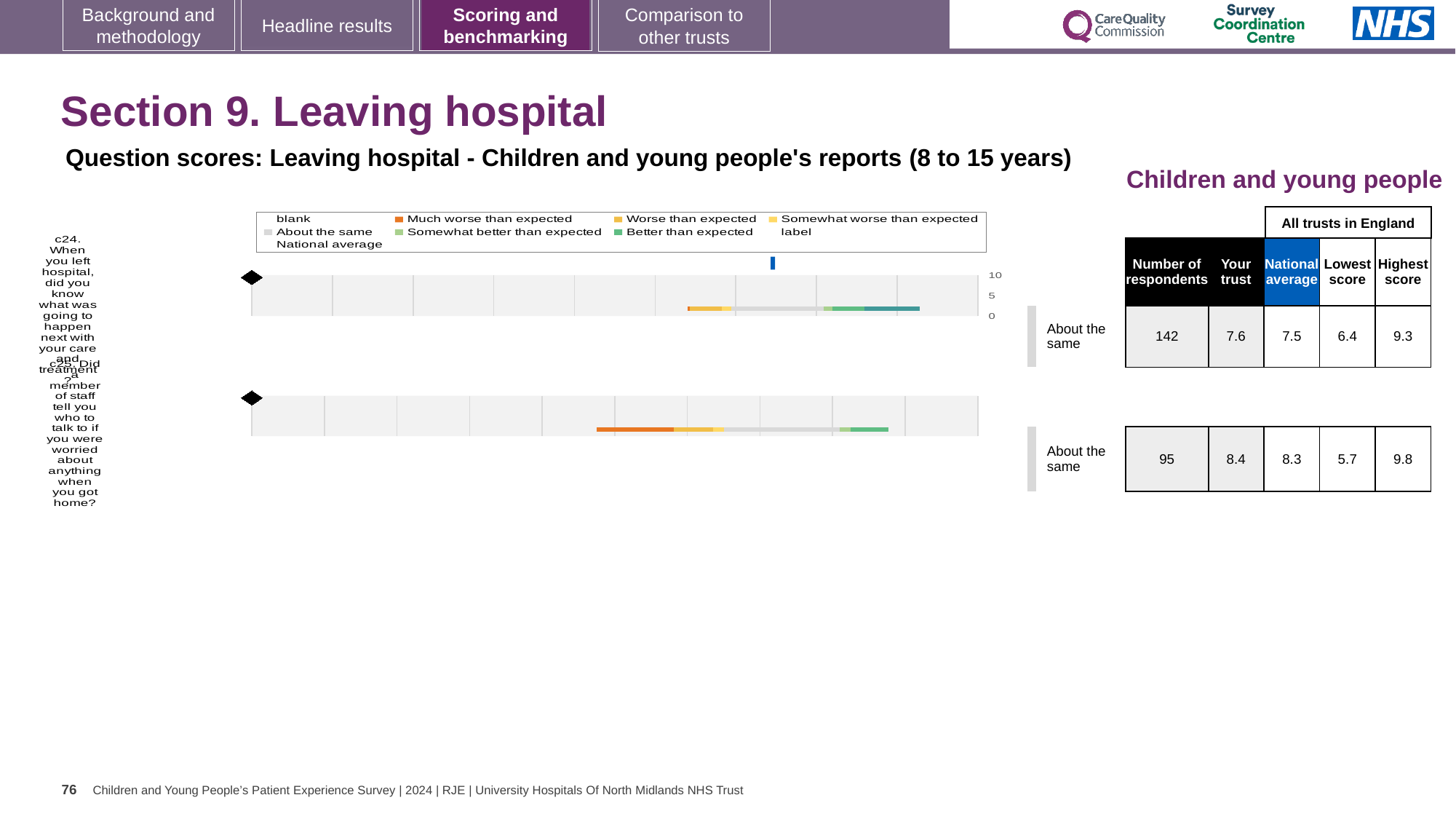
Which question has the higher 'Your trust' score, c24 or c25? c25 What is the highest score among all trusts in England for question c25? 9.8 Which question has the lower 'Lowest score' across all trusts in England, c24 or c25? c25 How many respondents answered question c24? 142 What is the difference between the trust's score and the national average for question c25? 0.1 What is the national average score for question c25 (Did a member of staff tell you who to talk to if you were worried about anything when you got home?)? 8.3 Which legend entry is shown in orange? Much worse than expected How many questions are plotted on the slide? 2 What is the 'Your trust' score for question c24 (When you left hospital, did you know what was going to happen next with your care and treatment?)? 7.6 What benchmark category is the trust given for question c24? About the same What kind of chart is used to show the question scores? Bar chart What is the lowest score among all trusts in England for question c24? 6.4